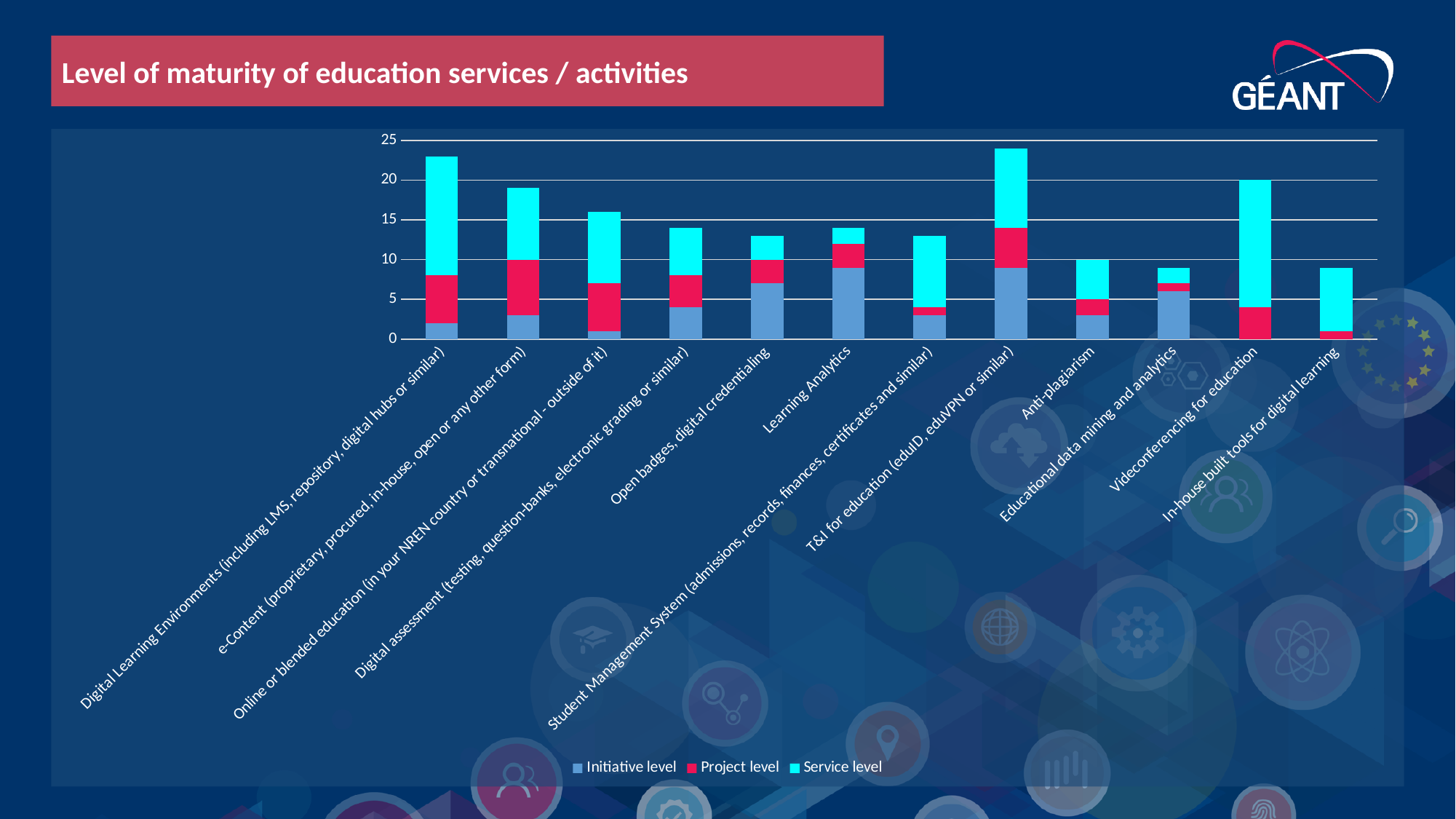
How many categories (education services / activities) are plotted on the x axis? 12 Which has the larger Initiative level value: Learning Analytics or Digital Learning Environments (including LMS, repository, digital hubs or similar)? Learning Analytics What are the three series named in the legend? Initiative level, Project level, Service level Is the Initiative level value for Learning Analytics greater or less than 5? greater Is the total stacked value for Digital Learning Environments (including LMS, repository, digital hubs or similar) greater or less than 20? greater Is the total stacked value for Anti-plagiarism greater or less than 15? less What is the title of the slide? Level of maturity of education services / activities What kind of chart is shown on the slide? Stacked bar chart Which has the larger total stacked value: Videoconferencing for education or Anti-plagiarism? Videoconferencing for education How many series does the legend list? 3